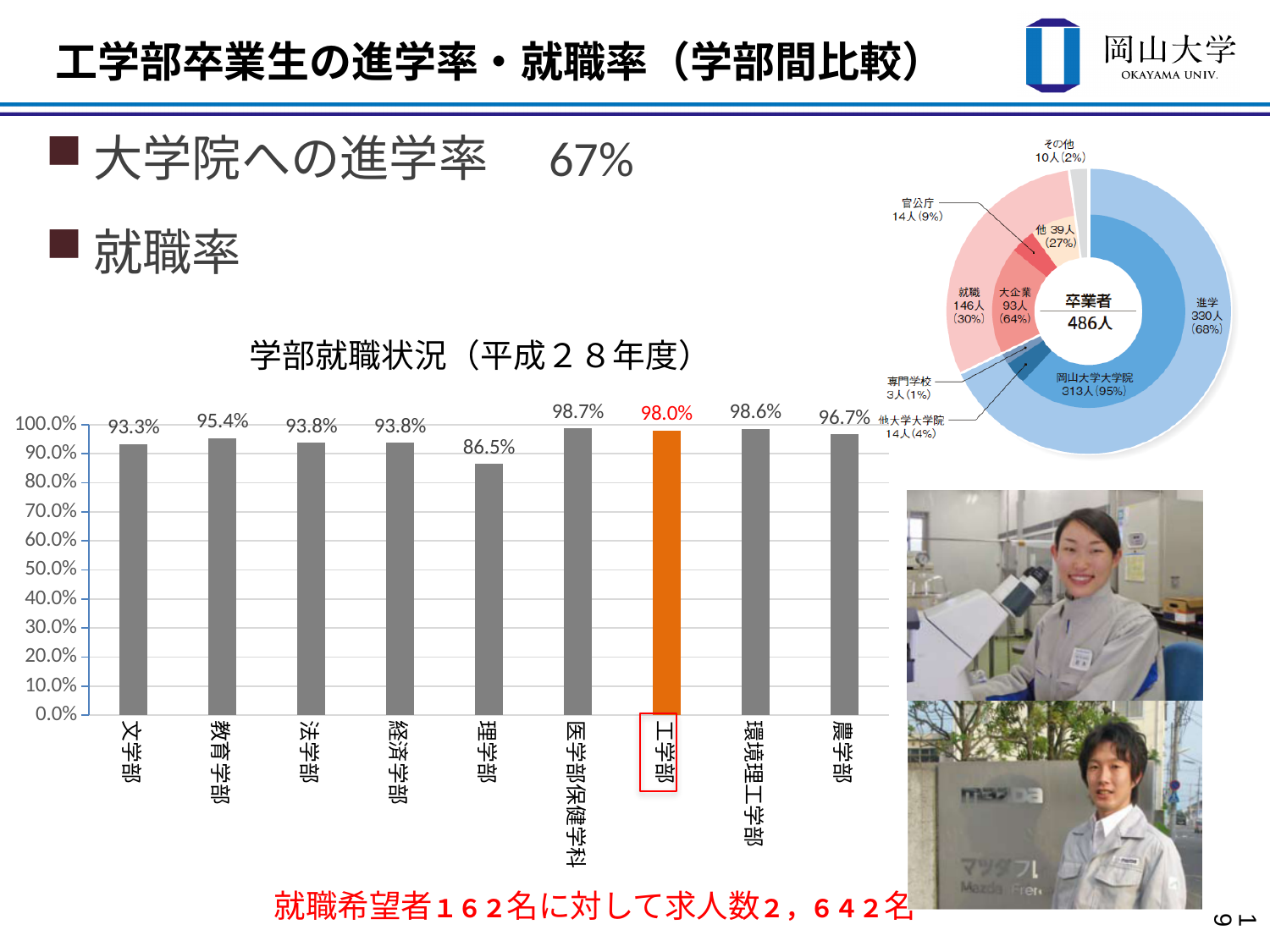
In the bar chart titled 学部就職状況（平成２８年度）, which is larger, 教育学部 or 文学部? 教育学部 In the bar chart titled 学部就職状況（平成２８年度）, what is the difference between 工学部 and 理学部? 11.5% What kind of chart is 学部就職状況（平成２８年度）? bar chart In the donut chart at the top right, how many graduates went to 岡山大学大学院? 313人 In the bar chart titled 学部就職状況（平成２８年度）, how many faculties are shown? 9 In the bar chart titled 学部就職状況（平成２８年度）, which bar is highlighted in orange? 工学部 In the bar chart titled 学部就職状況（平成２８年度）, what is the value for 理学部? 86.5% In the donut chart at the top right, what share of graduates went on to further study (進学)? 68% In the bar chart titled 学部就職状況（平成２８年度）, what is the value for 工学部? 98.0% In the bar chart titled 学部就職状況（平成２８年度）, what is the value for 農学部? 96.7% In the donut chart at the top right, how many graduates (卒業者) are shown in the centre? 486人 In the bar chart titled 学部就職状況（平成２８年度）, which faculty has the lowest value? 理学部